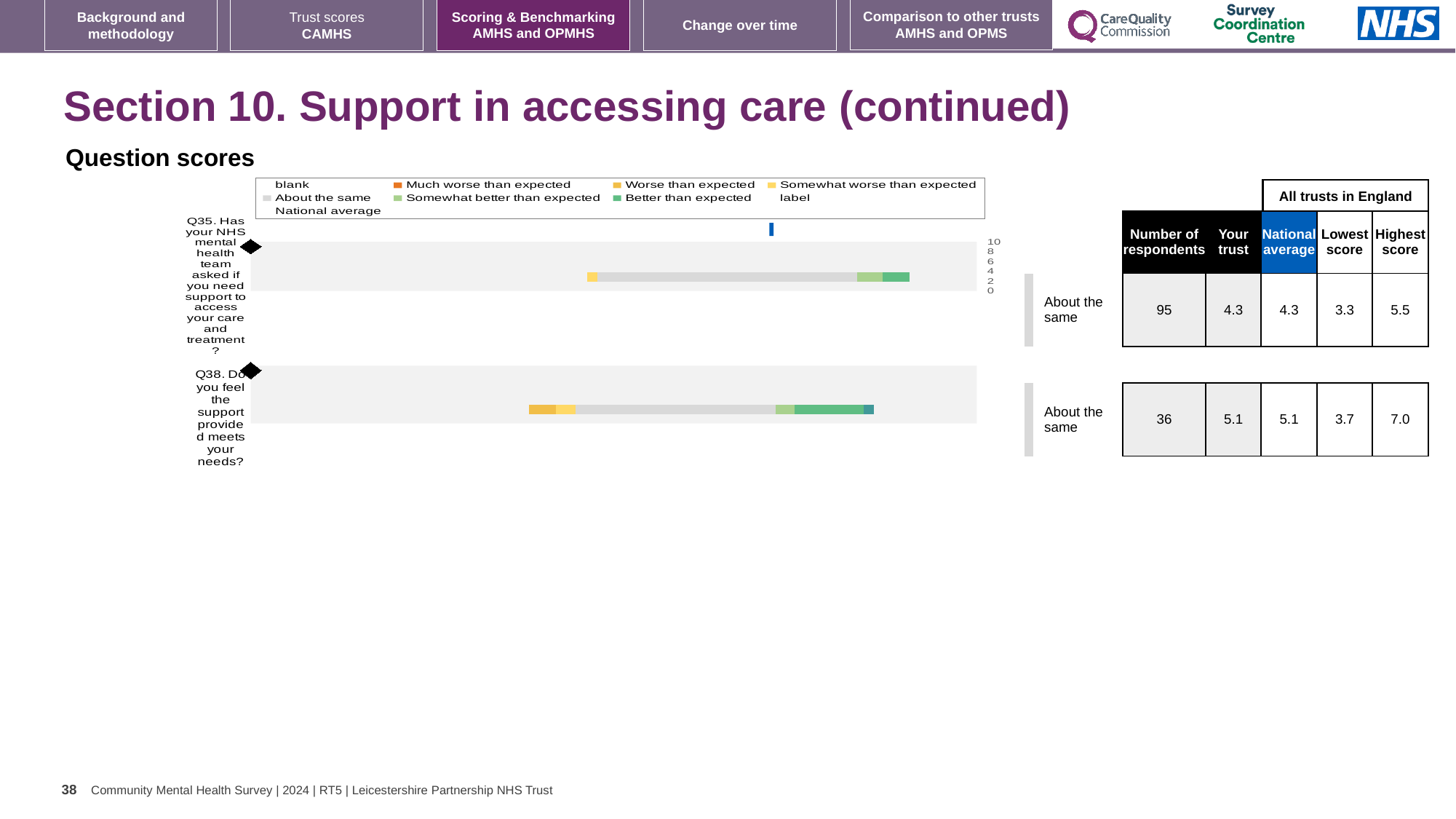
What benchmark category is shown for Q35? About the same What is the difference between the number of respondents for Q35 and Q38? 59 How many respondents answered Q38? 36 What kind of chart is shown under "Question scores"? bar chart What colour is used in the legend for "Better than expected"? green What is the "Your trust" score for Q38 (Do you feel the support provided meets your needs?)? 5.1 How many questions (bars) are plotted in the chart? 2 What is the lowest score across all trusts in England for Q38? 3.7 What is the "Your trust" score for Q35 (Has your NHS mental health team asked if you need support to access your care and treatment?)? 4.3 What is the highest score across all trusts in England for Q35? 5.5 What is the difference between the highest and lowest scores for Q38? 3.3 Which question has the higher "Your trust" score, Q35 or Q38? Q38